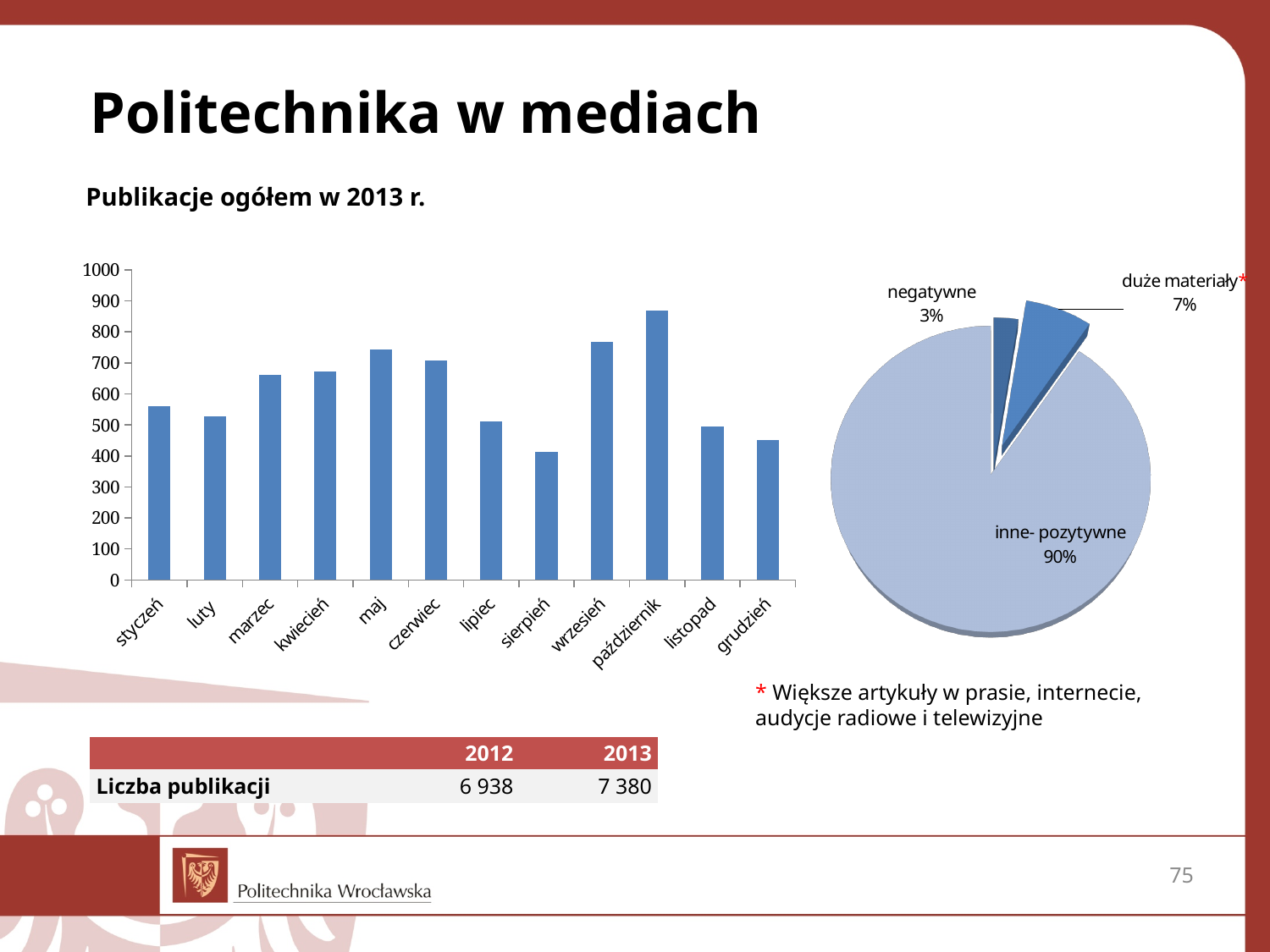
In the pie chart, what share is labelled 'inne- pozytywne'? 90% In the bar chart, is the value for sierpień greater or less than 500? less In the bar chart, how many months are shown on the x axis? 12 In the bar chart, is the value for październik greater or less than 800? greater What kind of chart is the left chart showing monthly values? bar chart In the bar chart, is the value for maj greater or less than 700? greater In the pie chart, what share is labelled 'negatywne'? 3% In the bar chart, which month has the highest bar? październik How many slices does the pie chart have? 3 In the bar chart, which is larger, the value for październik or the value for wrzesień? październik In the bar chart, which month has the lowest bar? sierpień In the bar chart, do the values rise or fall from październik to grudzień? fall